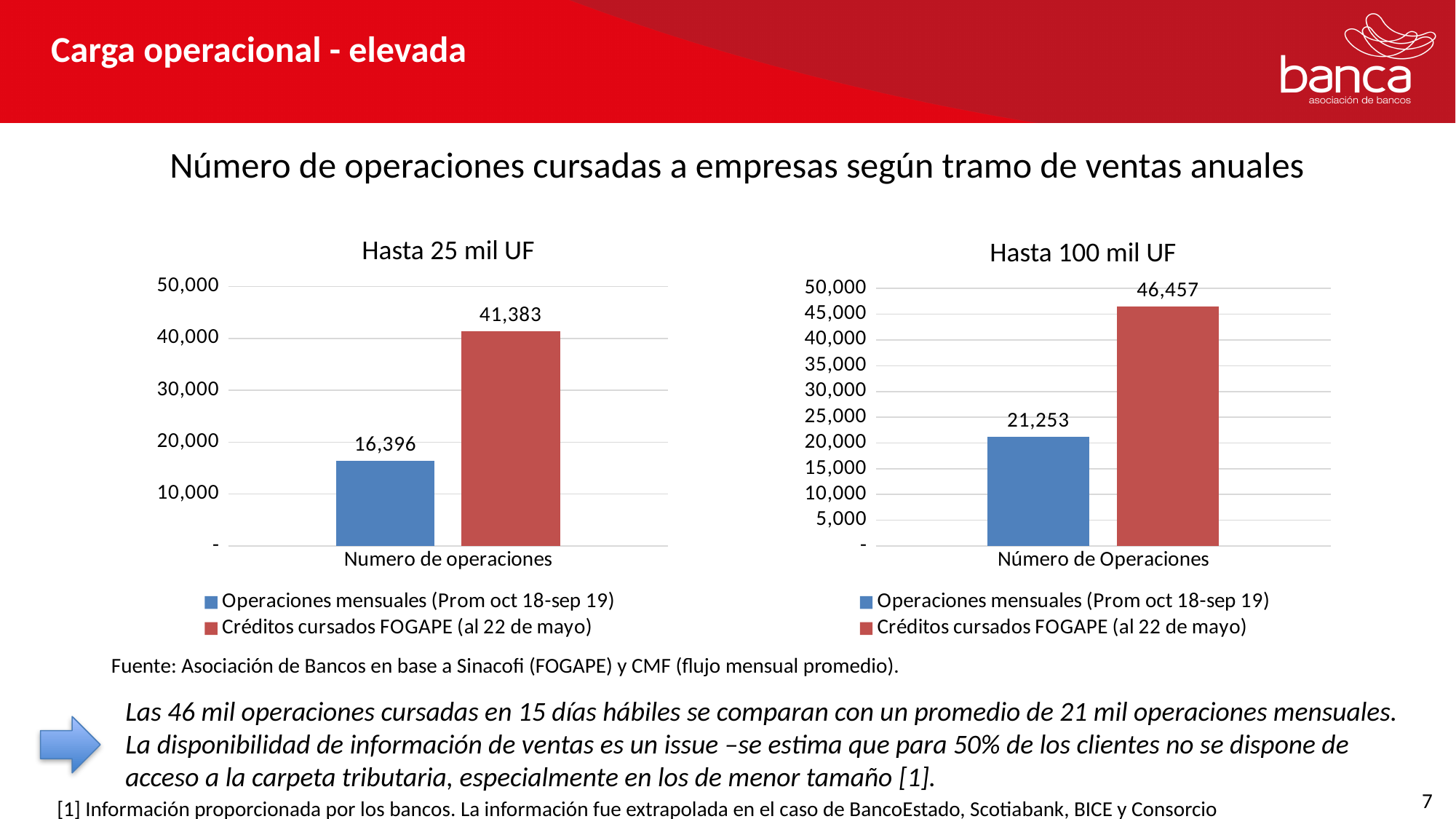
In the 'Hasta 25 mil UF' chart, what is the value for Operaciones mensuales (Prom oct 18-sep 19)? 16,396 What colour is the Créditos cursados FOGAPE (al 22 de mayo) bar in the 'Hasta 100 mil UF' chart? Red In the 'Hasta 25 mil UF' chart, is the value for Créditos cursados FOGAPE greater or less than 40,000? greater In the 'Hasta 25 mil UF' chart, what is the value for Créditos cursados FOGAPE (al 22 de mayo)? 41,383 How many series does the legend of the 'Hasta 100 mil UF' chart list? 2 In the 'Hasta 25 mil UF' chart, what is the difference between Créditos cursados FOGAPE and Operaciones mensuales? 24,987 In the 'Hasta 100 mil UF' chart, what is the value for Operaciones mensuales (Prom oct 18-sep 19)? 21,253 In the 'Hasta 100 mil UF' chart, which series has the higher value? Créditos cursados FOGAPE (al 22 de mayo) In the 'Hasta 100 mil UF' chart, what is the value for Créditos cursados FOGAPE (al 22 de mayo)? 46,457 What kind of chart is the 'Hasta 25 mil UF' chart? Bar chart In the 'Hasta 25 mil UF' chart, which series has the lower value? Operaciones mensuales (Prom oct 18-sep 19) In the 'Hasta 100 mil UF' chart, what is the difference between Créditos cursados FOGAPE and Operaciones mensuales? 25,204